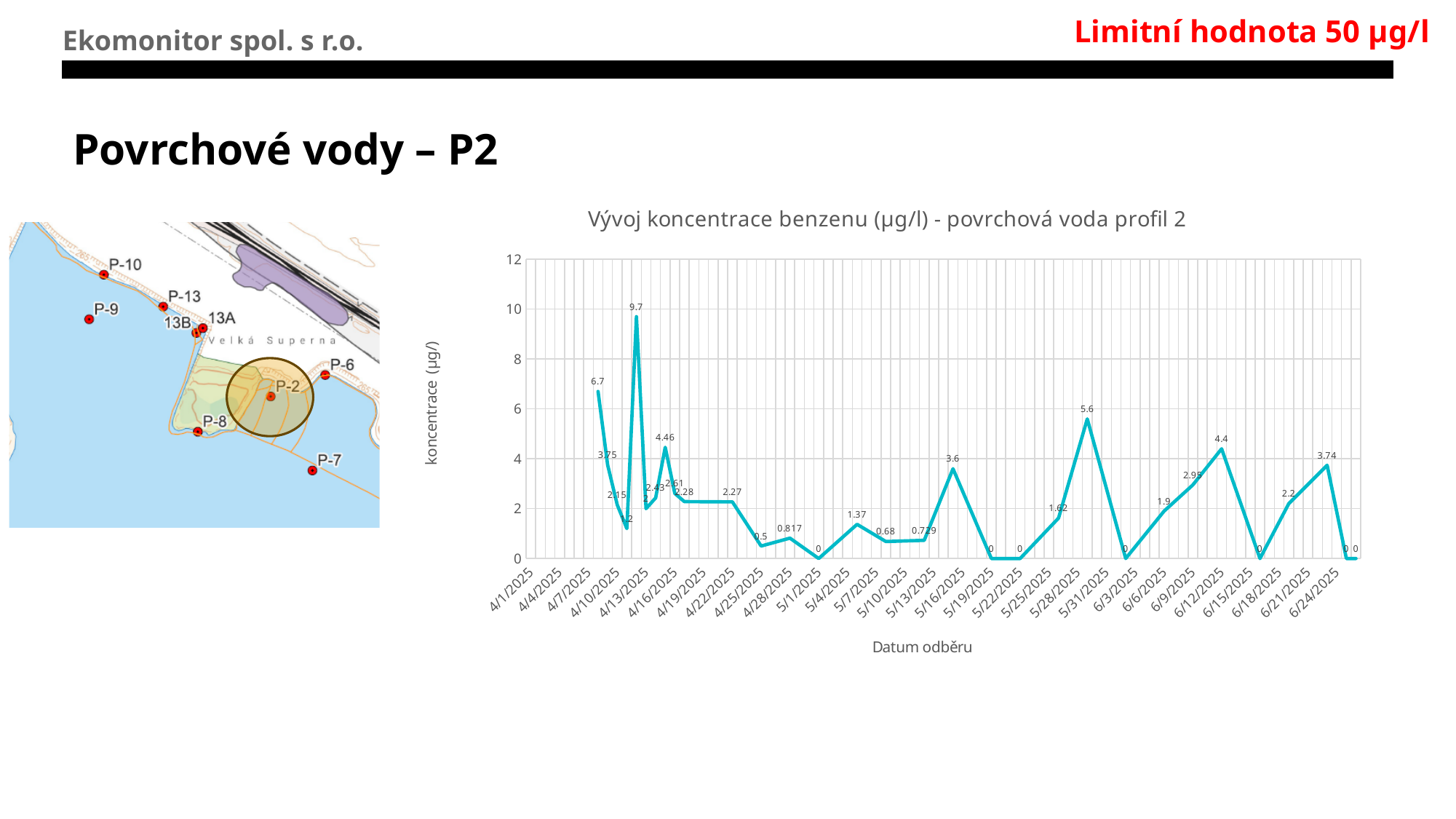
What is the difference between the highest labelled value (9.7) and the second-highest labelled value (6.7)? 3 What is the value of the first plotted point on the chart? 6.7 How many data series (lines) are plotted on the chart? 1 What is the title of the chart? Vývoj koncentrace benzenu (µg/l) - povrchová voda profil 2 What is the label of the horizontal axis? Datum odběru What type of chart is shown on the slide? line chart Which is larger, the peak labelled 4.46 or the peak labelled 4.4? 4.46 What is the difference between the peak value 9.7 and the peak value 5.6? 4.1 Is the highest value on the chart greater or less than 10? less What is the highest benzene concentration value labelled on the chart? 9.7 What is the maximum value shown on the vertical axis? 12 What is the value of the last plotted point on the chart? 0